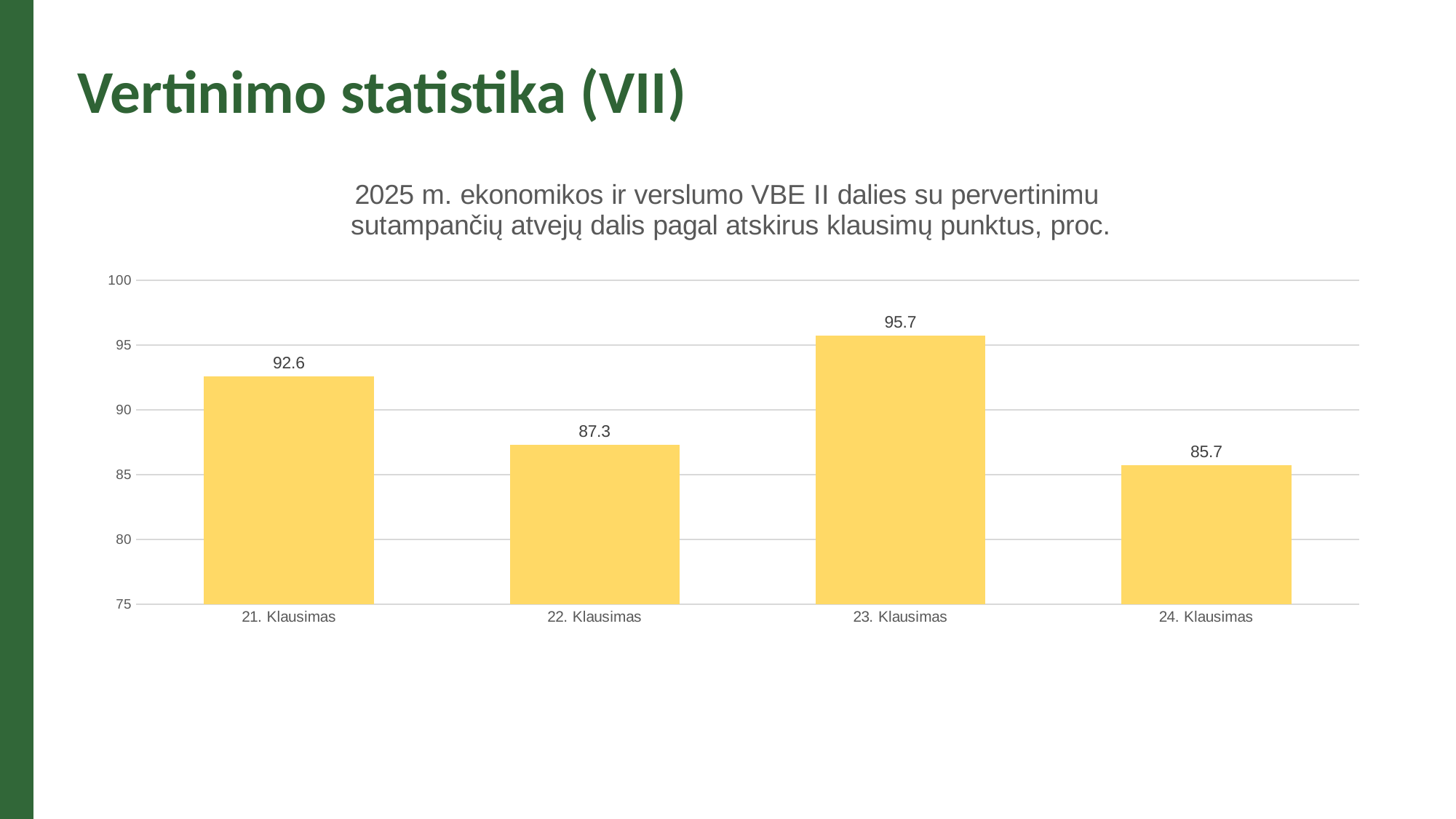
Which is larger, the value for 22. Klausimas or the value for 24. Klausimas? 22. Klausimas How many categories are shown on the chart? 4 Is the value for 21. Klausimas greater or less than 90? greater What kind of chart is shown on the slide? bar chart What is the value for 23. Klausimas? 95.7 What is the difference between the values for 23. Klausimas and 24. Klausimas? 10 What is the difference between the values for 21. Klausimas and 22. Klausimas? 5.3 What is the value for 24. Klausimas? 85.7 Which category has the lowest value? 24. Klausimas Which category has the highest value? 23. Klausimas What is the value for 21. Klausimas? 92.6 What is the value for 22. Klausimas? 87.3